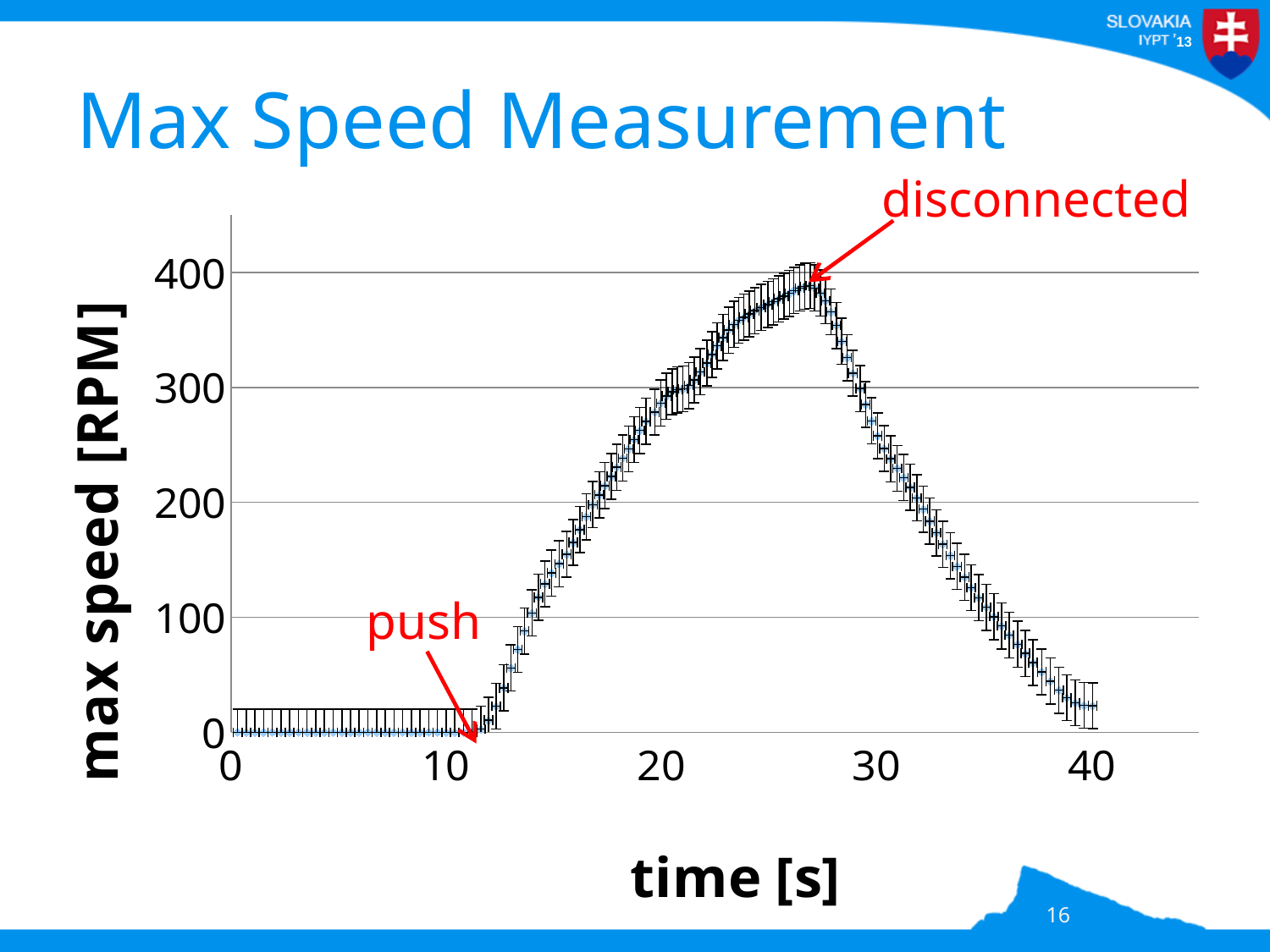
Is the peak max speed greater or less than 300 RPM? greater Which is larger, the max speed at 20 s or the max speed at 40 s? 20 s Is the max speed at time 35 s greater or less than 200 RPM? less Does the max speed rise or fall between the 'push' point and the 'disconnected' point? rise What is the label of the y axis? max speed [RPM] Is the max speed at time 20 s greater or less than 200 RPM? greater Does the max speed rise or fall after the 'disconnected' point? fall What kind of chart is shown on the slide? line chart with error bars Which is larger, the max speed at 15 s or the max speed at 25 s? 25 s What is the title of the chart on the slide? Max Speed Measurement